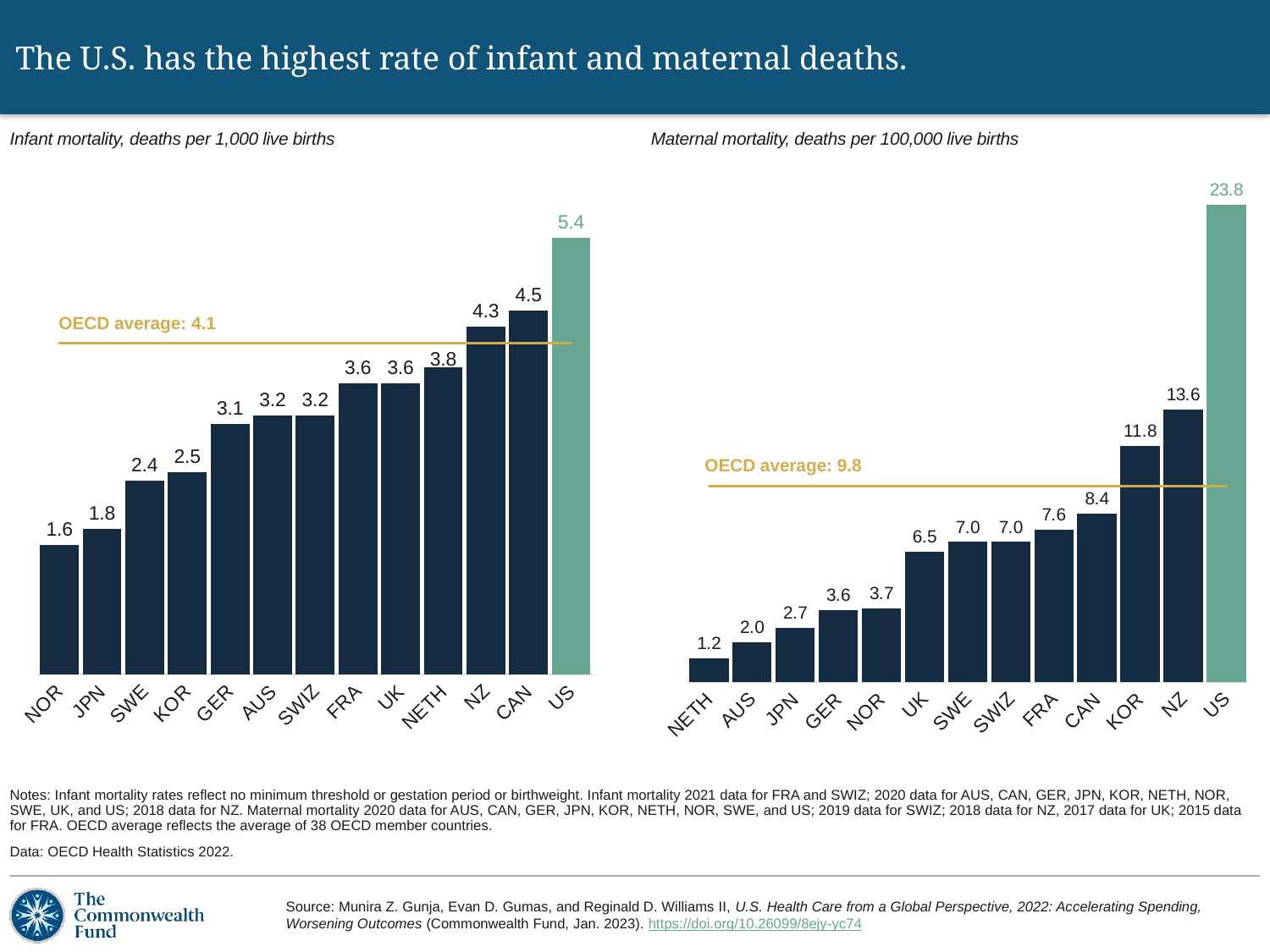
In the maternal mortality chart, what is the value for KOR? 11.8 In the infant mortality chart, what is the value for the US? 5.4 In the maternal mortality chart, which country has the highest value? US In the maternal mortality chart, do the values rise or fall from left to right? Rise How many countries are shown in the infant mortality chart? 13 What kind of chart is the maternal mortality chart? Bar chart In the maternal mortality chart, which is larger, the value for NETH or the value for JPN? JPN In the maternal mortality chart, what is the difference between the US and NZ values? 10.2 In the infant mortality chart, what is the difference between the CAN and NOR values? 2.9 What OECD average is marked on the infant mortality chart? 4.1 In the infant mortality chart, which country has the lowest value? NOR In the infant mortality chart, which is larger, the value for GER or the value for FRA? FRA